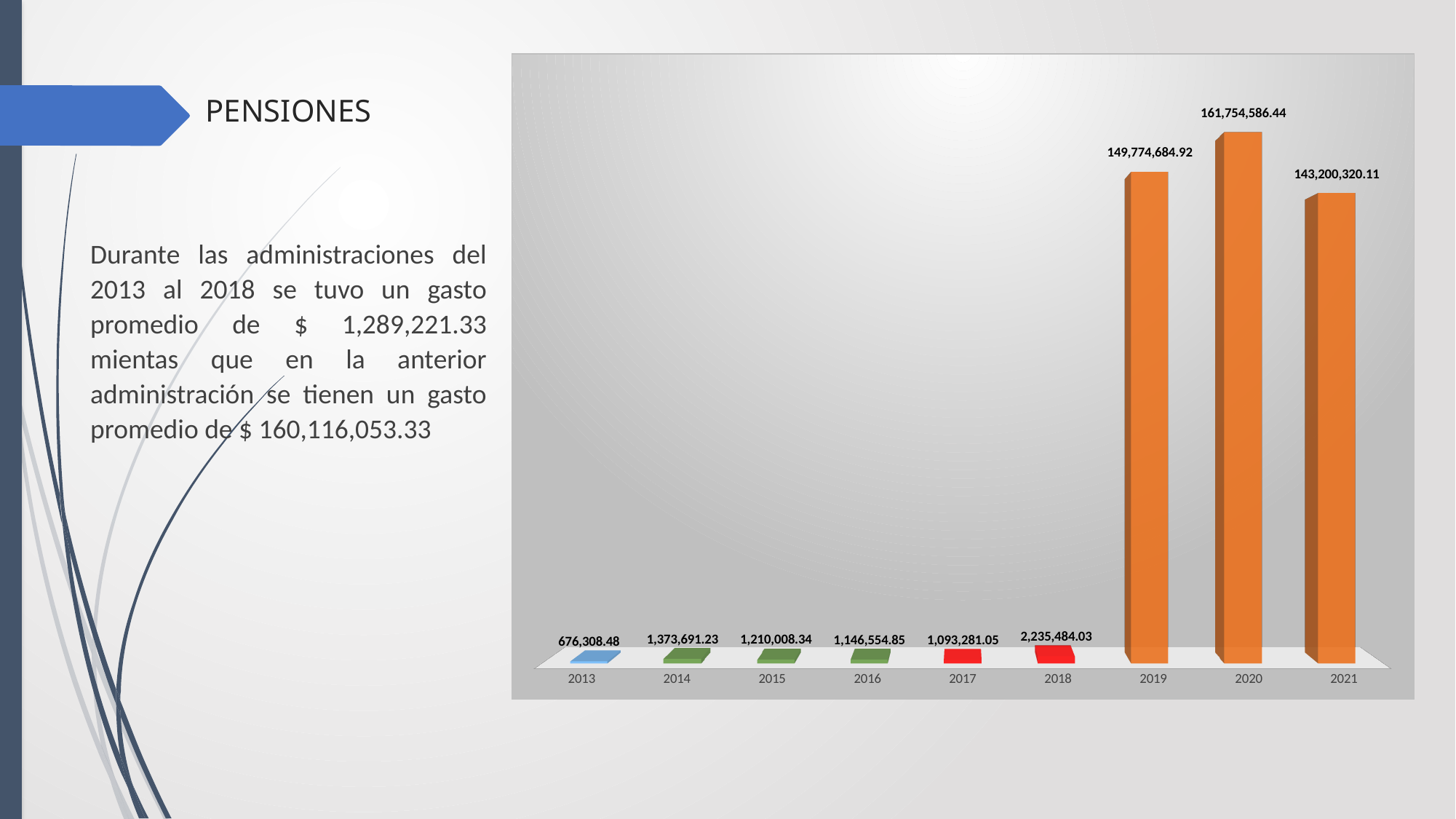
Which year has the lowest value? 2013 What is the difference between the values for 2020 and 2019? 11,979,901.52 What is the value shown for 2018? 2,235,484.03 What is the value shown for 2020? 161,754,586.44 Do the values rise or fall from 2014 to 2017? fall Which is larger, the value for 2014 or the value for 2015? 2014 What is the difference between the values for 2018 and 2017? 1,142,202.98 What is the value shown for 2013? 676,308.48 Which year has the highest value? 2020 What is the value shown for 2021? 143,200,320.11 What kind of chart is shown on the slide? bar chart How many years are shown on the x axis? 9